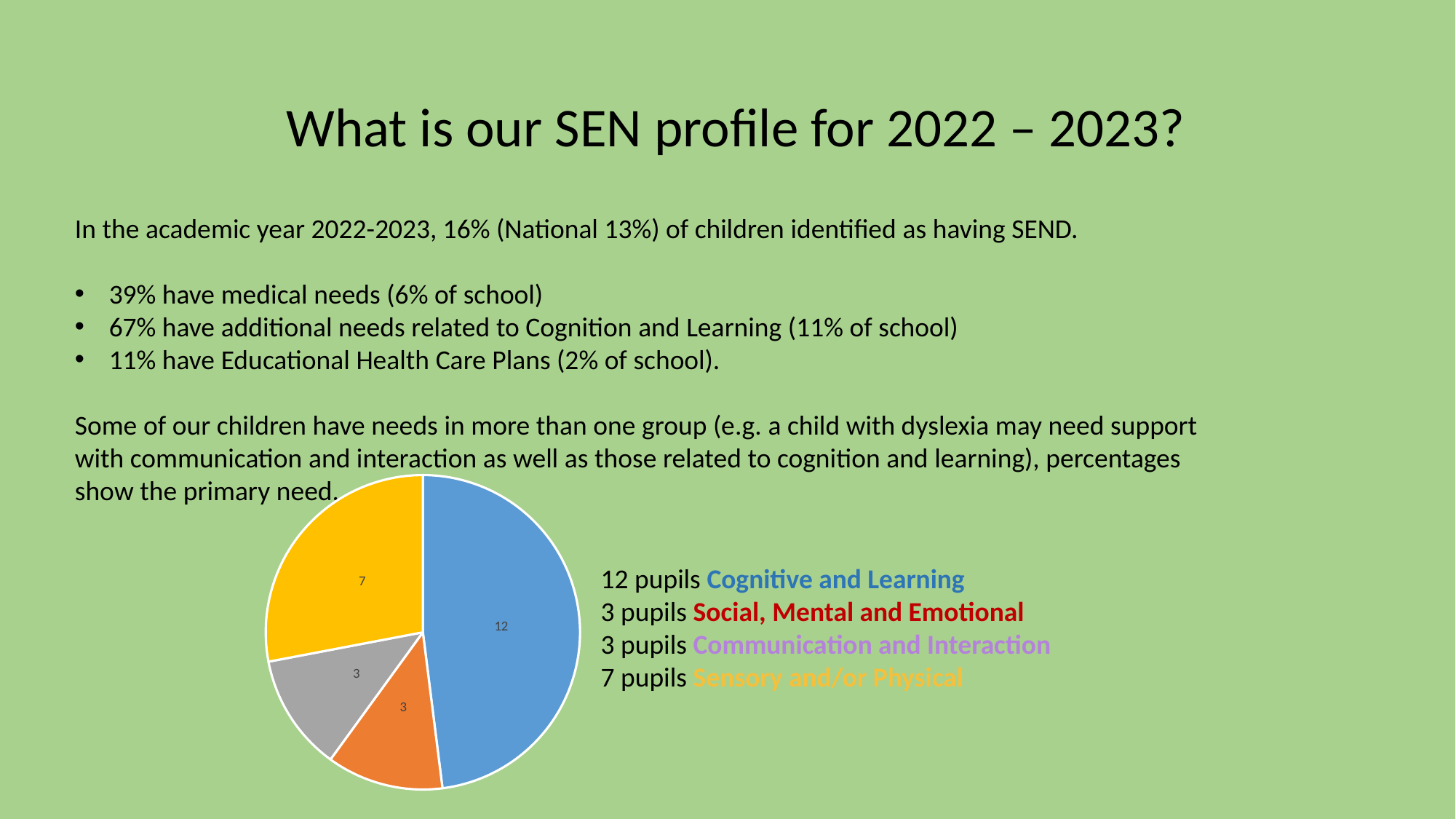
What is the total number of pupils represented in the pie chart? 25 How many pupils are in the Cognitive and Learning slice of the pie chart? 12 How many pupils are in the Communication and Interaction slice of the pie chart? 3 Which category has the largest slice of the pie chart? Cognitive and Learning Which is larger, the Sensory and/or Physical slice or the Social, Mental and Emotional slice? Sensory and/or Physical What kind of chart is shown on the slide? pie chart How many pupils are in the Sensory and/or Physical slice of the pie chart? 7 What colour is the Cognitive and Learning slice of the pie chart? blue What share of the pie chart does the Cognitive and Learning slice represent? 48% What is the difference in pupils between the Cognitive and Learning slice and the Sensory and/or Physical slice? 5 How many slices does the pie chart have? 4 How many pupils are in the Social, Mental and Emotional slice of the pie chart? 3